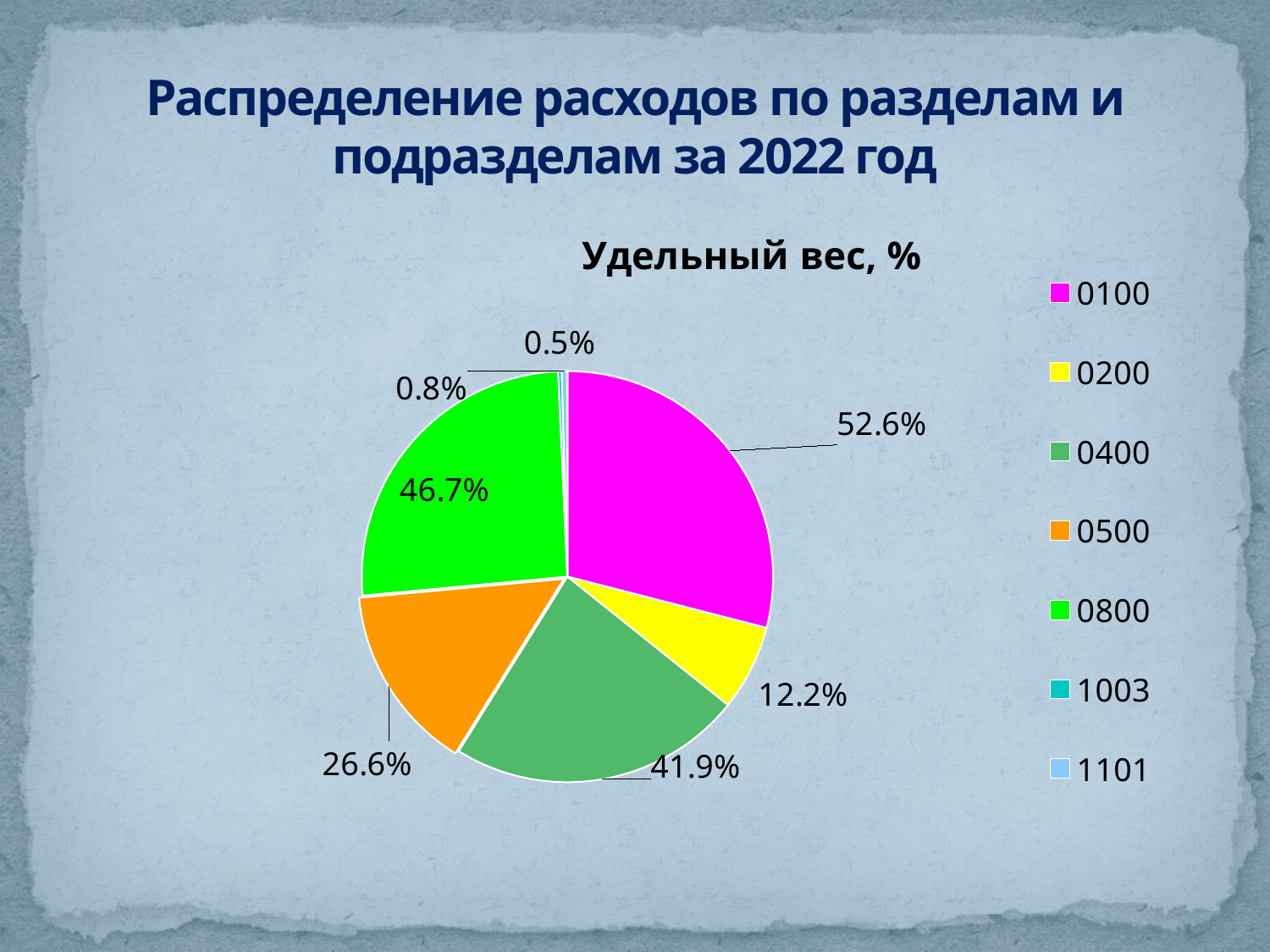
What is the title of the chart? Удельный вес, % Which is larger, the value for 0500 or the value for 0200? 0500 What is the value labelled for category 0800? 46.7% What is the value labelled for category 0100? 52.6% What colour is the slice for category 0500? orange Which category has the largest labelled value? 0100 What type of chart is shown on the slide? pie chart Which category has the smallest labelled value? 1003 What is the value labelled for category 0400? 41.9% What is the value labelled for category 0200? 12.2% How many categories does the legend list? 7 What is the value labelled for category 0500? 26.6%